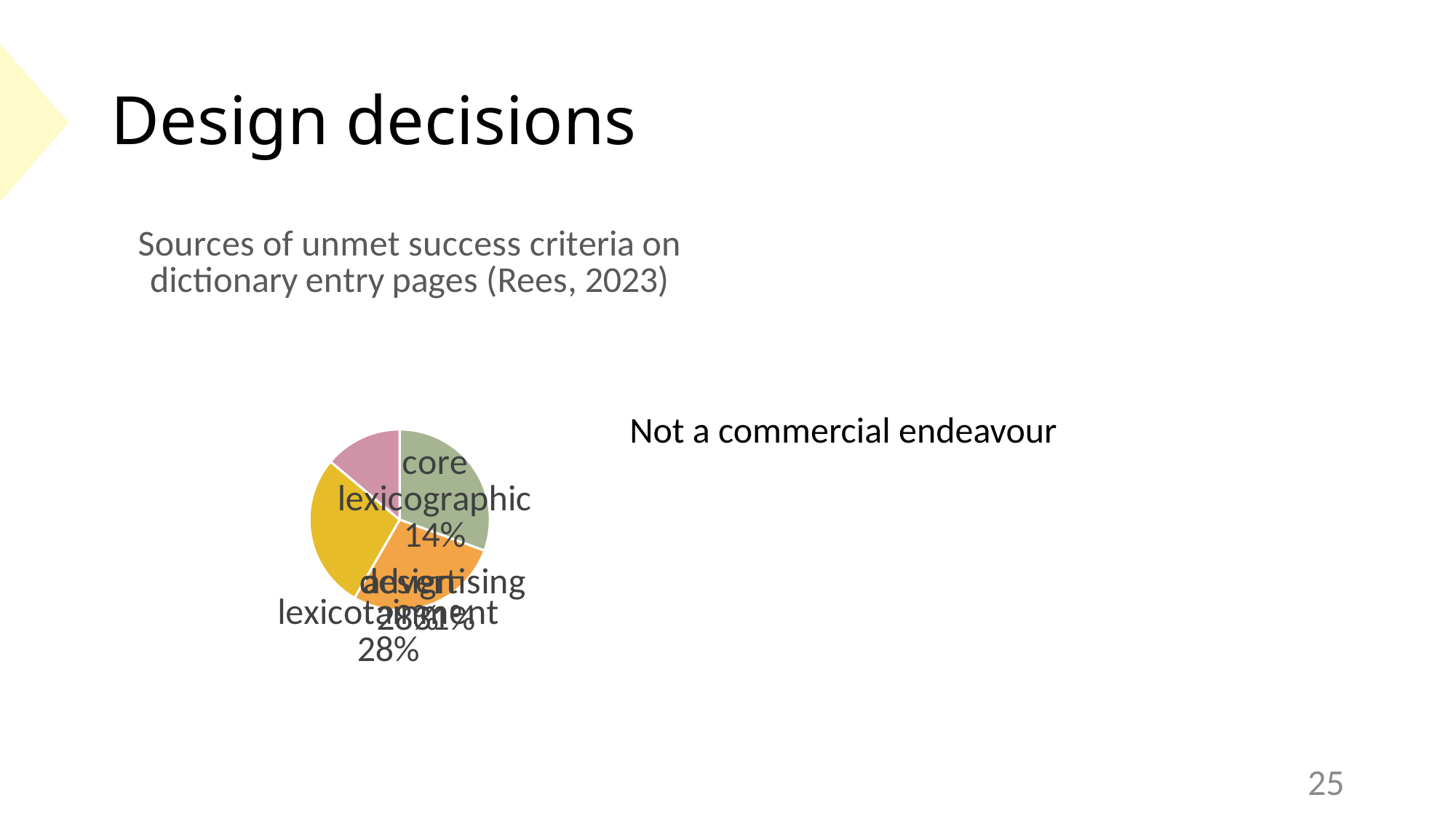
What kind of chart is shown on the slide? pie chart What share of the pie does lexicotainment have? 28% How many slices does the pie chart have? 4 What is the title of the pie chart? Sources of unmet success criteria on dictionary entry pages (Rees, 2023) Is the share for lexicotainment greater or less than 20%? greater